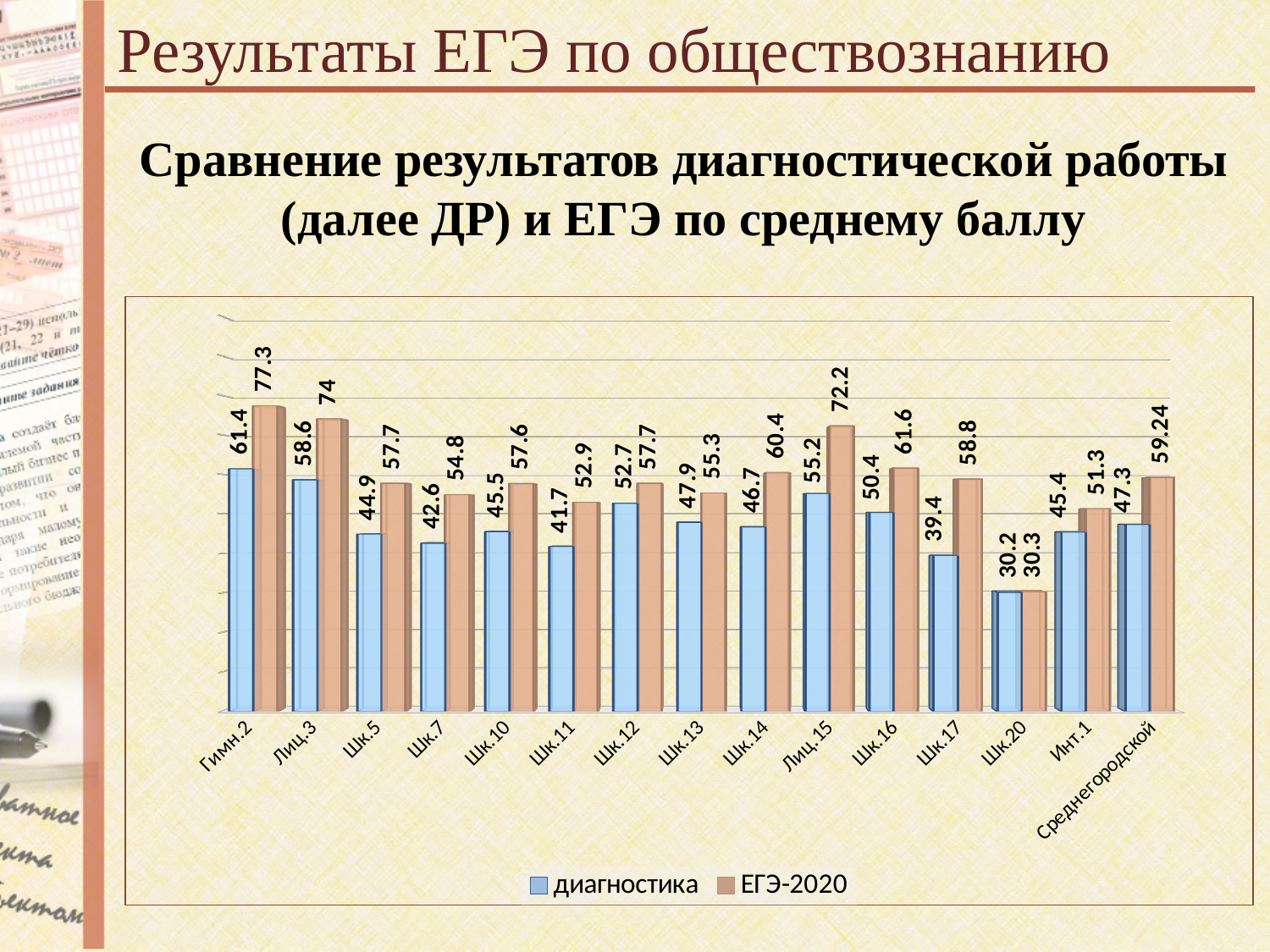
What is the difference between the ЕГЭ-2020 and диагностика values for Шк.17? 19.4 How many categories are shown on the x axis? 15 What is the диагностика value for Гимн.2? 61.4 How many series does the legend list? 2 What are the two series named in the legend? диагностика and ЕГЭ-2020 What is the ЕГЭ-2020 value for Среднегородской? 59.24 What is the difference between the ЕГЭ-2020 values for Гимн.2 and Лиц.3? 3.3 Which category has the lowest диагностика value? Шк.20 Which category has the highest ЕГЭ-2020 value? Гимн.2 What kind of chart is shown on the slide? Bar chart Which is larger for Шк.12: the диагностика value or the ЕГЭ-2020 value? ЕГЭ-2020 What is the ЕГЭ-2020 value for Лиц.15? 72.2